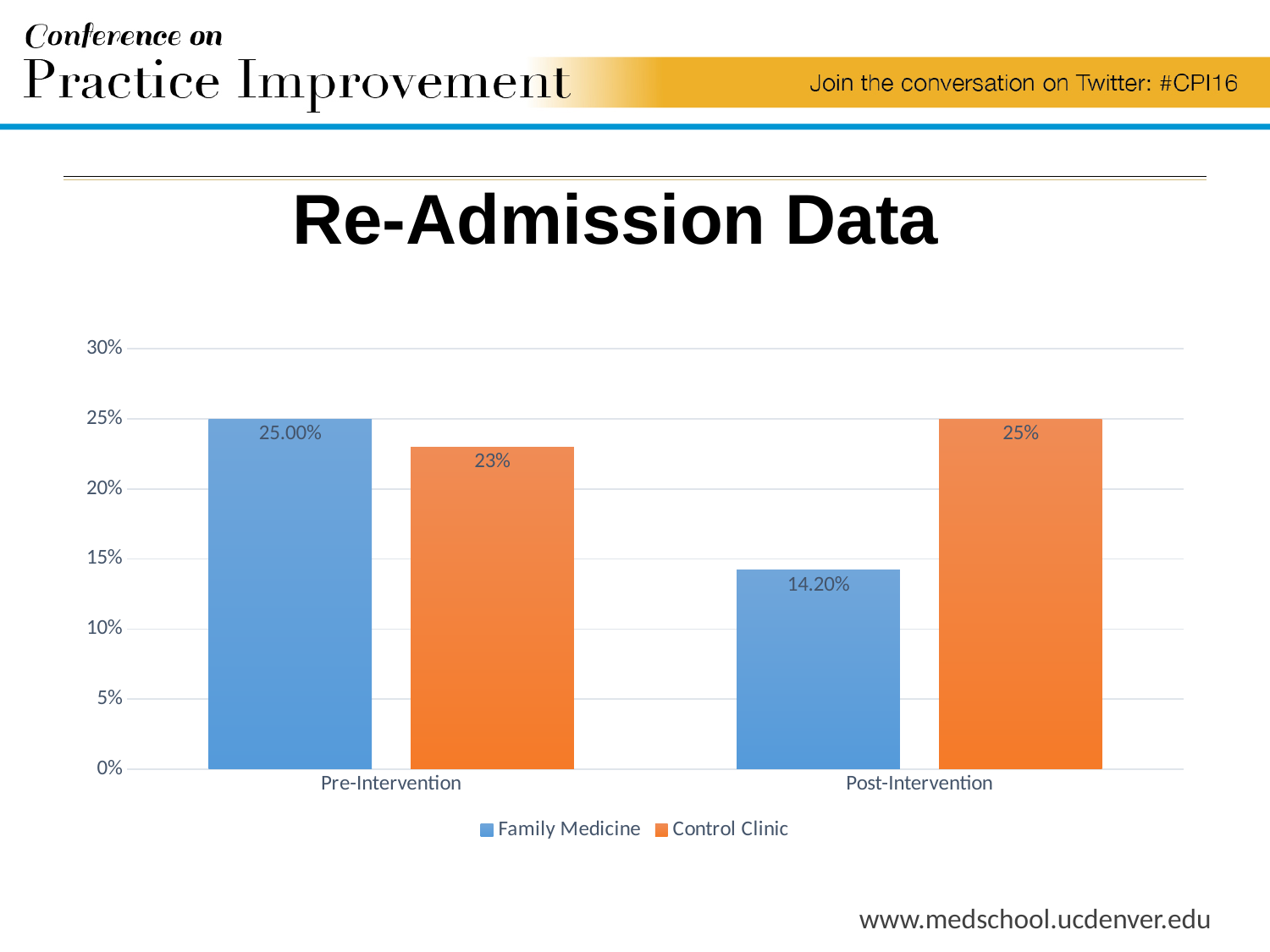
How many series does the legend list? 2 What is the Control Clinic value for Post-Intervention? 25% What is the Family Medicine value for Post-Intervention? 14.20% For Post-Intervention, which series has the larger value, Family Medicine or Control Clinic? Control Clinic Which category has the highest Control Clinic value? Post-Intervention What is the Control Clinic value for Pre-Intervention? 23% What is the Family Medicine value for Pre-Intervention? 25.00% What kind of chart is shown on the slide? bar chart What is the difference between the Family Medicine values for Pre-Intervention and Post-Intervention? 10.80% How many categories are shown on the x axis? 2 Which category has the lowest Family Medicine value? Post-Intervention Is the Family Medicine value for Post-Intervention greater or less than 15%? less